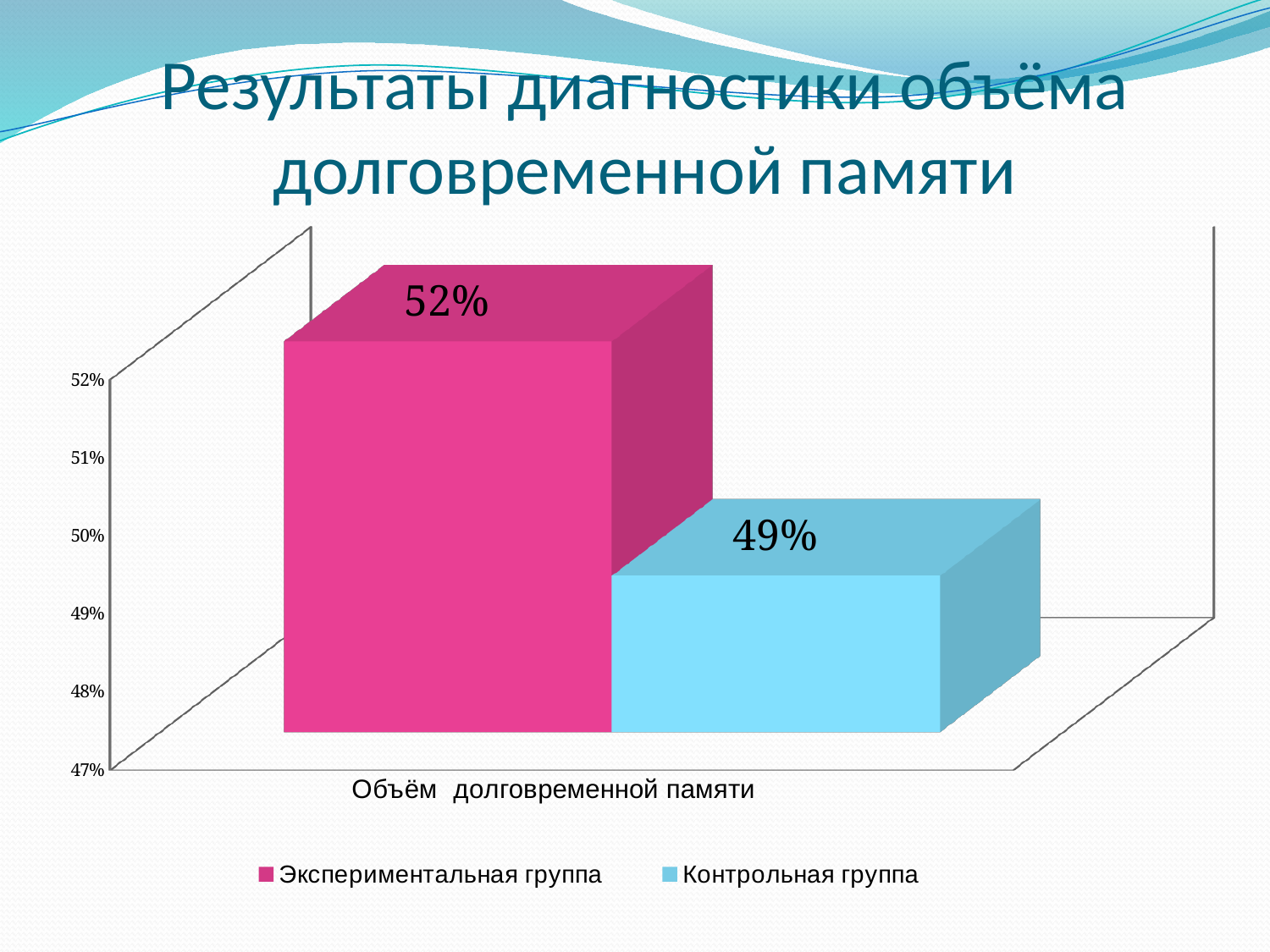
What colour is the bar for Контрольная группа? light blue Which series has the highest value? Экспериментальная группа What is the category label on the x axis? Объём долговременной памяти Which is larger, the value for Экспериментальная группа or for Контрольная группа? Экспериментальная группа Is the value for Экспериментальная группа greater or less than 50%? greater How many series does the legend list? 2 What is the difference between the values for Экспериментальная группа and Контрольная группа? 3% What is the value for Экспериментальная группа? 52% Is the value for Контрольная группа greater or less than 50%? less What is the value for Контрольная группа? 49% What kind of chart is shown on the slide? bar chart Which series has the lowest value? Контрольная группа